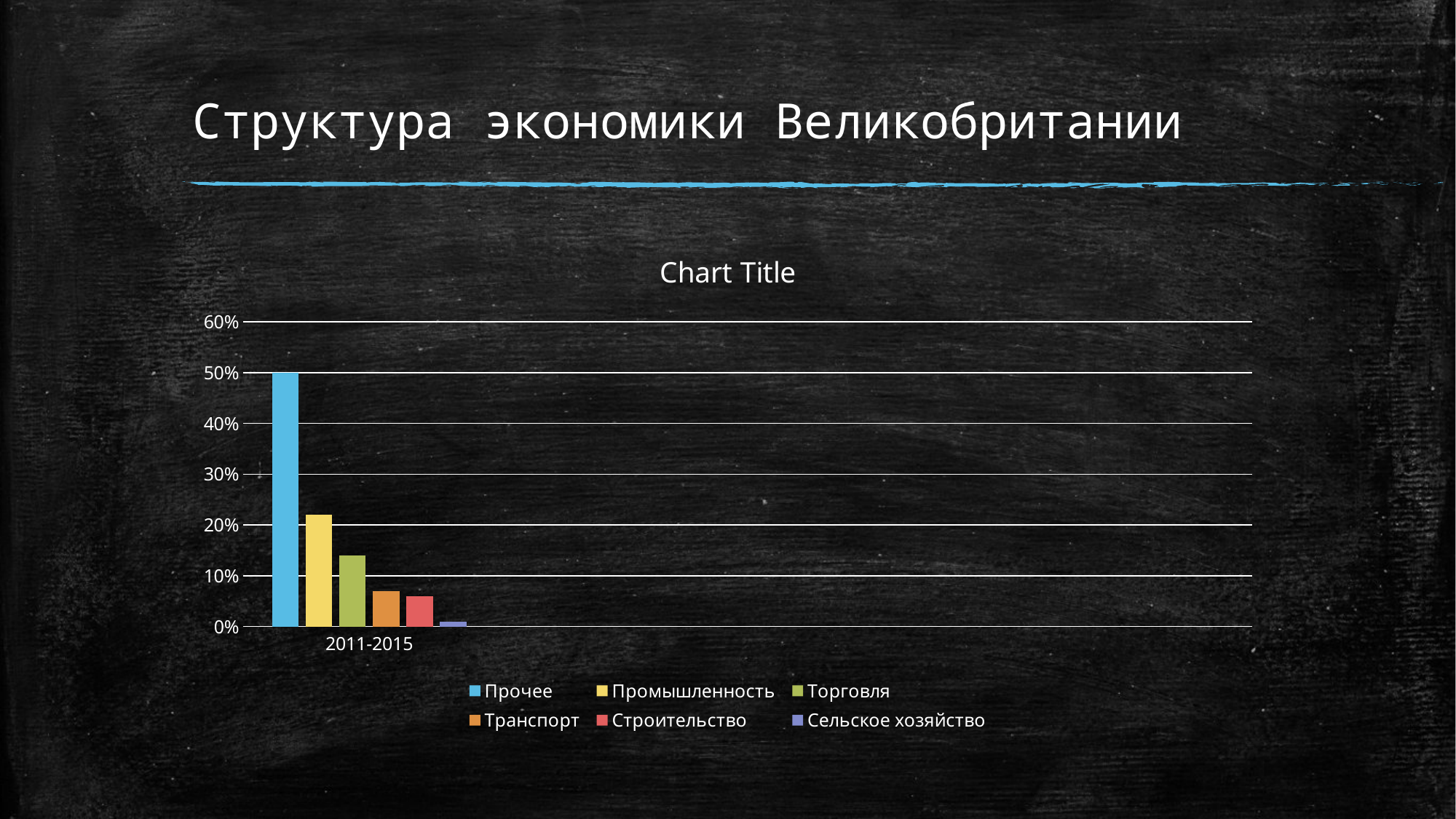
Which is larger, the value for Промышленность or the value for Торговля? Промышленность Which series has the highest value? Прочее What is the category label on the x axis? 2011-2015 What is the value for Прочее? 50% How many categories are shown on the x axis? 1 What kind of chart is shown on the slide? bar chart Is the value for Торговля greater or less than 20%? less How many series does the legend list? 6 What is the title shown above the chart? Chart Title Is the value for Промышленность greater or less than 20%? greater Is the value for Транспорт greater or less than 10%? less Which series has the lowest value? Сельское хозяйство